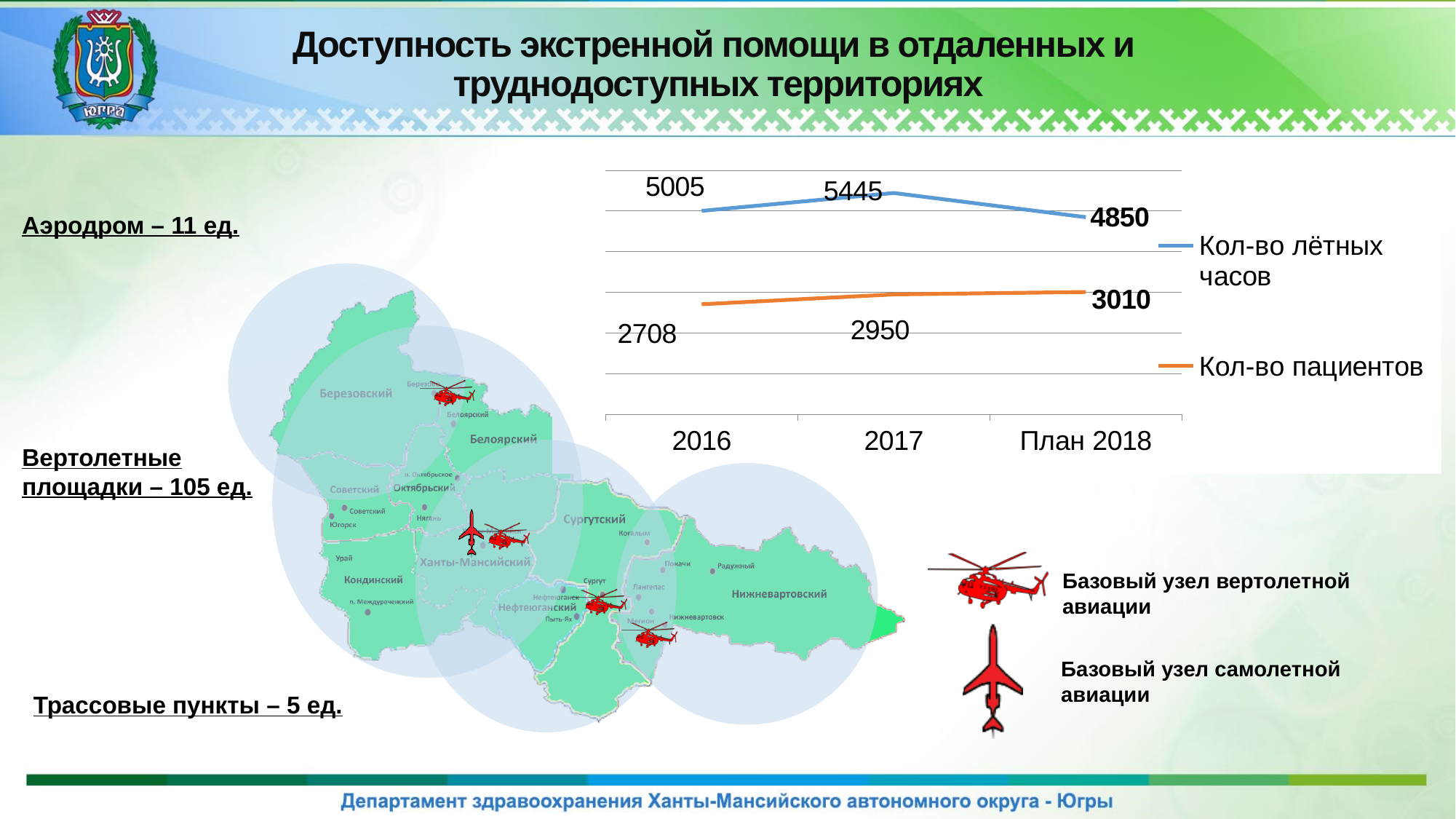
What type of chart is shown on the slide? Line chart In which year is "Кол-во лётных часов" highest? 2017 In which year is "Кол-во пациентов" lowest? 2016 Does "Кол-во пациентов" rise or fall from 2016 to План 2018? Rise How many points are plotted along the x axis of the chart? 3 What is the difference between "Кол-во лётных часов" in 2017 and in План 2018? 595 What is the value of "Кол-во пациентов" in 2016? 2708 What is the planned value of "Кол-во лётных часов" for 2018 (План 2018)? 4850 How many series does the chart legend list? 2 What is the value of "Кол-во лётных часов" in 2017? 5445 What is the planned value of "Кол-во пациентов" for 2018 (План 2018)? 3010 What is the value of "Кол-во лётных часов" in 2016? 5005